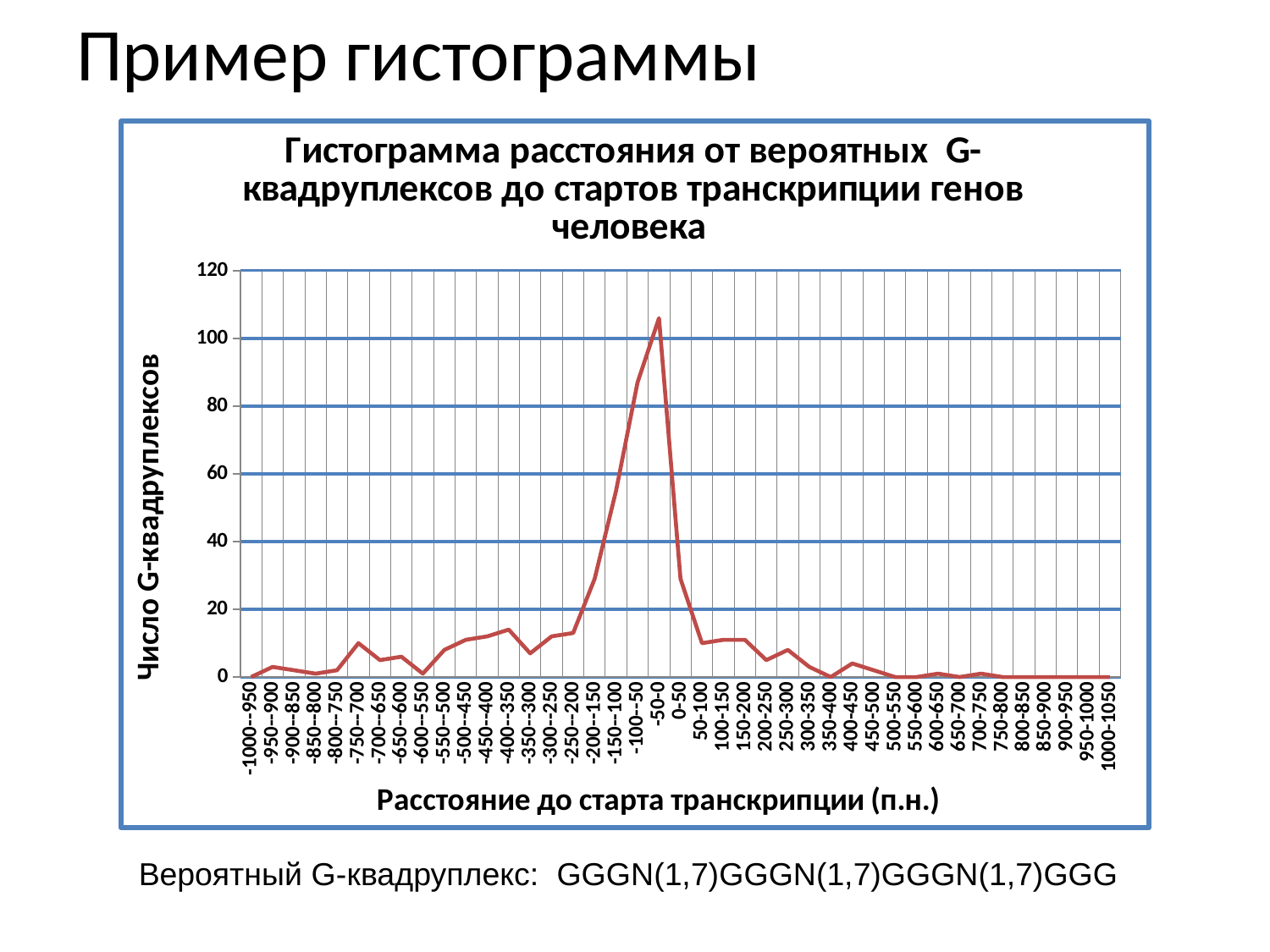
Is the value for the -100--50 bin greater or less than 80? greater Which is larger, the value for the -100--50 bin or the value for the 0-50 bin? -100--50 What kind of chart is shown on the slide? line chart What is the title of the x axis? Расстояние до старта транскрипции (п.н.) Is the value for the 0-50 bin greater or less than 20? greater Is the value for the -750--700 bin greater or less than 20? less Which distance bin has the highest number of G-quadruplexes? -50-0 Which is larger, the value for the -50-0 bin or the value for the -150--100 bin? -50-0 What is the title of the y axis? Число G-квадруплексов How many distance bins are shown on the x axis? 41